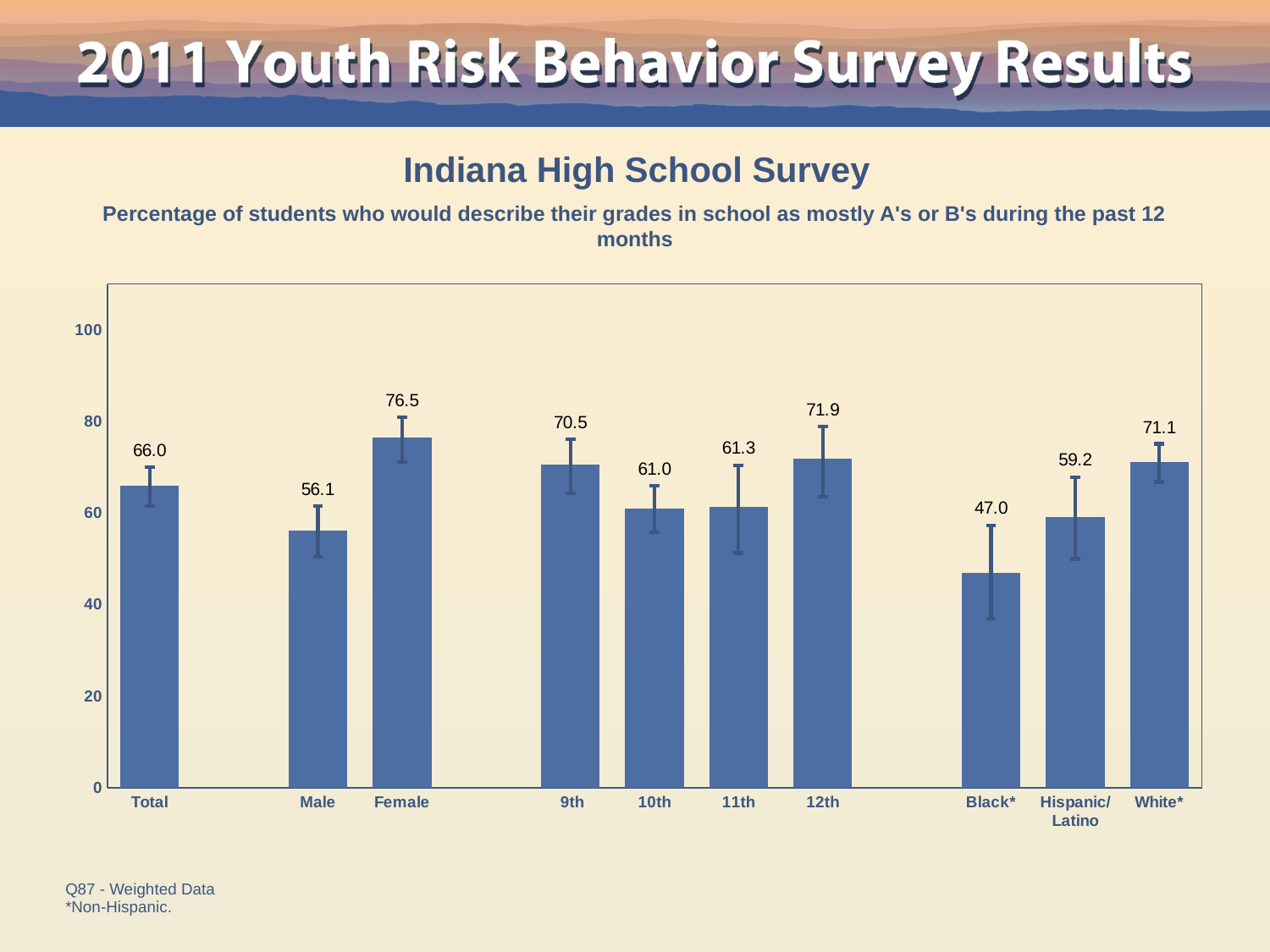
What is the difference between the White* and Black* values? 24.1 What is the title of the chart? Indiana High School Survey Is the value for Hispanic/Latino greater or less than 60? less How many categories are shown on the x axis? 10 Which category has the highest value? Female What is the value for Female? 76.5 What is the difference between the Female and Male values? 20.4 Which is larger, the value for 9th or the value for 10th? 9th What is the value for Black*? 47.0 What is the value for Total? 66.0 Which category has the lowest value? Black* What kind of chart is this? bar chart